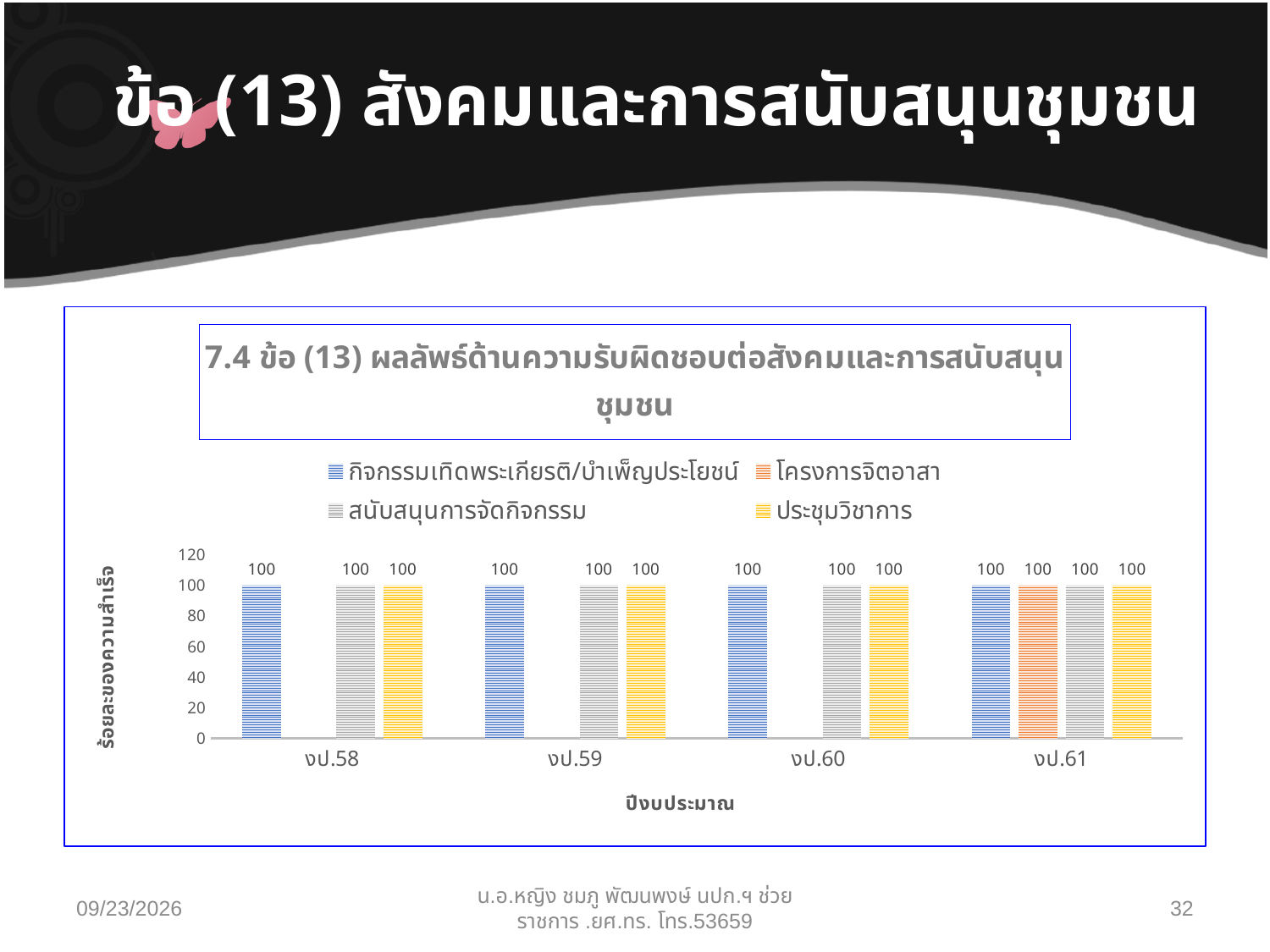
Is the value for ประชุมวิชาการ in งป.61 greater or less than 80? greater What is the value for กิจกรรมเทิดพระเกียรติ/บำเพ็ญประโยชน์ in งป.58? 100 How many series does the legend list? 4 What is the value for โครงการจิตอาสา in งป.61? 100 In which budget year does the โครงการจิตอาสา series have a bar? งป.61 How many budget-year categories are shown on the x axis? 4 What is the difference between the value for กิจกรรมเทิดพระเกียรติ/บำเพ็ญประโยชน์ and ประชุมวิชาการ in งป.59? 0 What is the label of the y axis? ร้อยละของความสำเร็จ What kind of chart is shown on the slide? bar chart What is the value for ประชุมวิชาการ in งป.60? 100 What is the value for สนับสนุนการจัดกิจกรรม in งป.59? 100 Do the values for กิจกรรมเทิดพระเกียรติ/บำเพ็ญประโยชน์ rise, fall, or stay the same from งป.58 to งป.61? stay the same